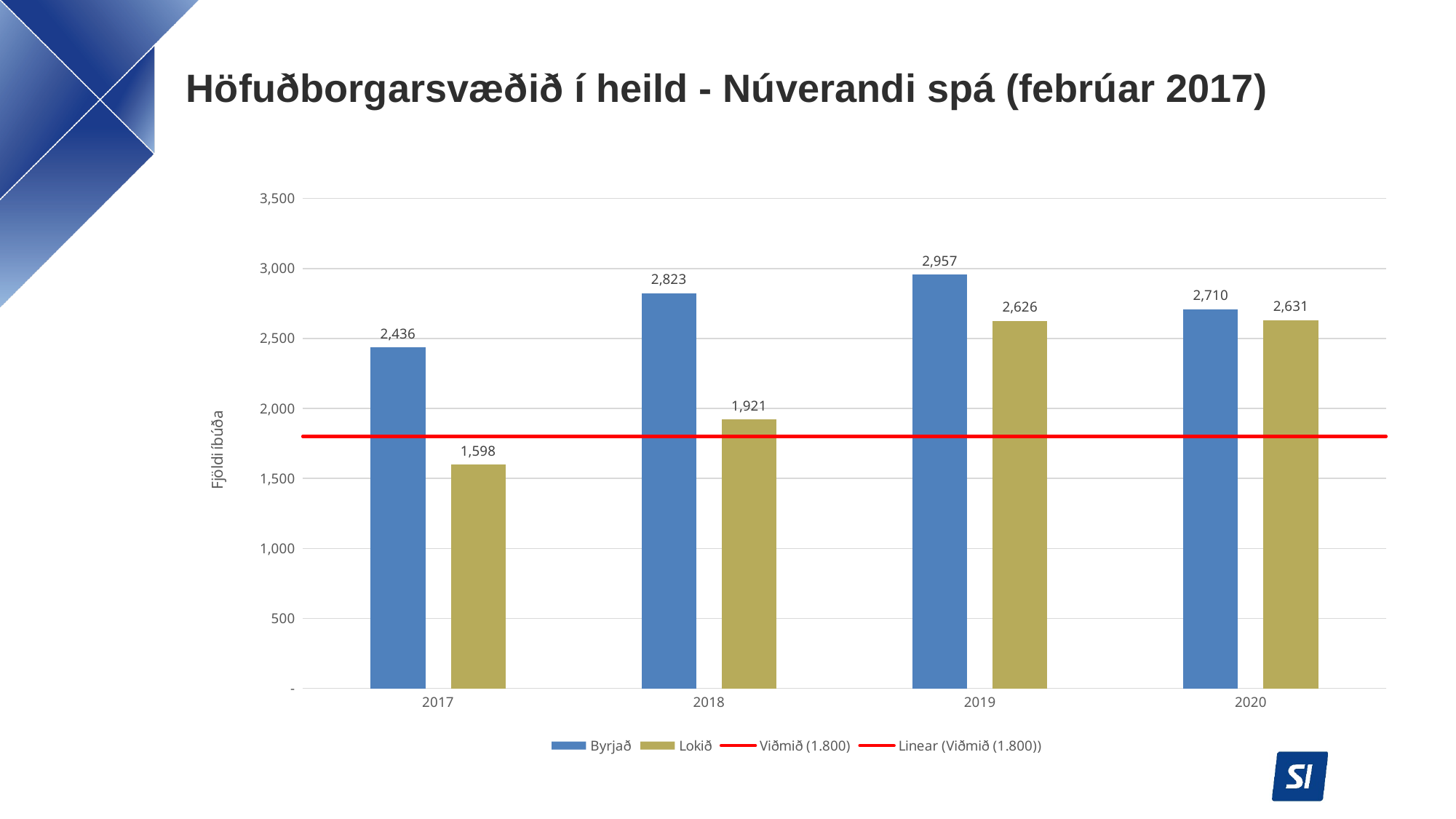
How many years are shown on the x axis? 4 What is the difference between Byrjað and Lokið in 2019? 331 Which is larger in 2020, Byrjað or Lokið? Byrjað What is the value of Lokið for 2020? 2,631 Is the Lokið value for 2018 greater or less than 2,000? less In which year is the Byrjað value highest? 2019 How many entries does the legend list? 4 What is the label of the vertical axis? Fjöldi íbúða What is the value of Byrjað for 2018? 2,823 What kind of chart is shown on the slide? bar chart What is the value of Lokið for 2017? 1,598 In which year is the Lokið value lowest? 2017